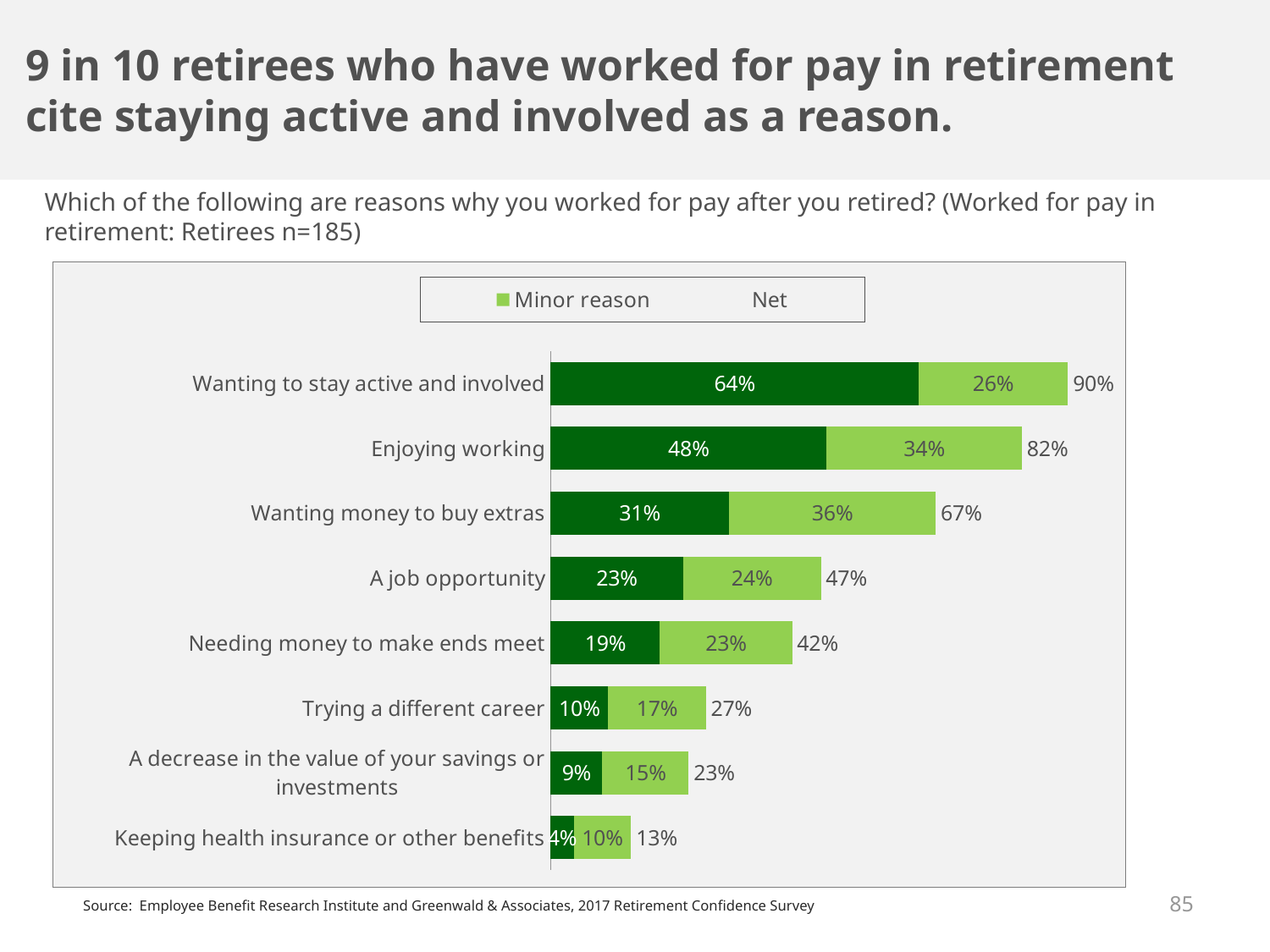
Which reason has the highest Net value? Wanting to stay active and involved What is the Minor reason value for "Enjoying working"? 34% What kind of chart is shown on the slide? Stacked bar chart How many reasons (categories) are shown in the chart? 8 What is the difference between the Net values for "Wanting to stay active and involved" and "Enjoying working"? 8 percentage points Which reason has the lowest Net value? Keeping health insurance or other benefits Which colour represents "Minor reason" in the legend? Light green What is the value of the dark green segment for "A job opportunity"? 23% Which has the larger Minor reason value: "Wanting money to buy extras" or "Wanting to stay active and involved"? Wanting money to buy extras What is the total (Net) of the stacked bar for "Trying a different career"? 27% What is the Minor reason value for "Keeping health insurance or other benefits"? 10% What is the Net value for "Wanting money to buy extras"? 67%